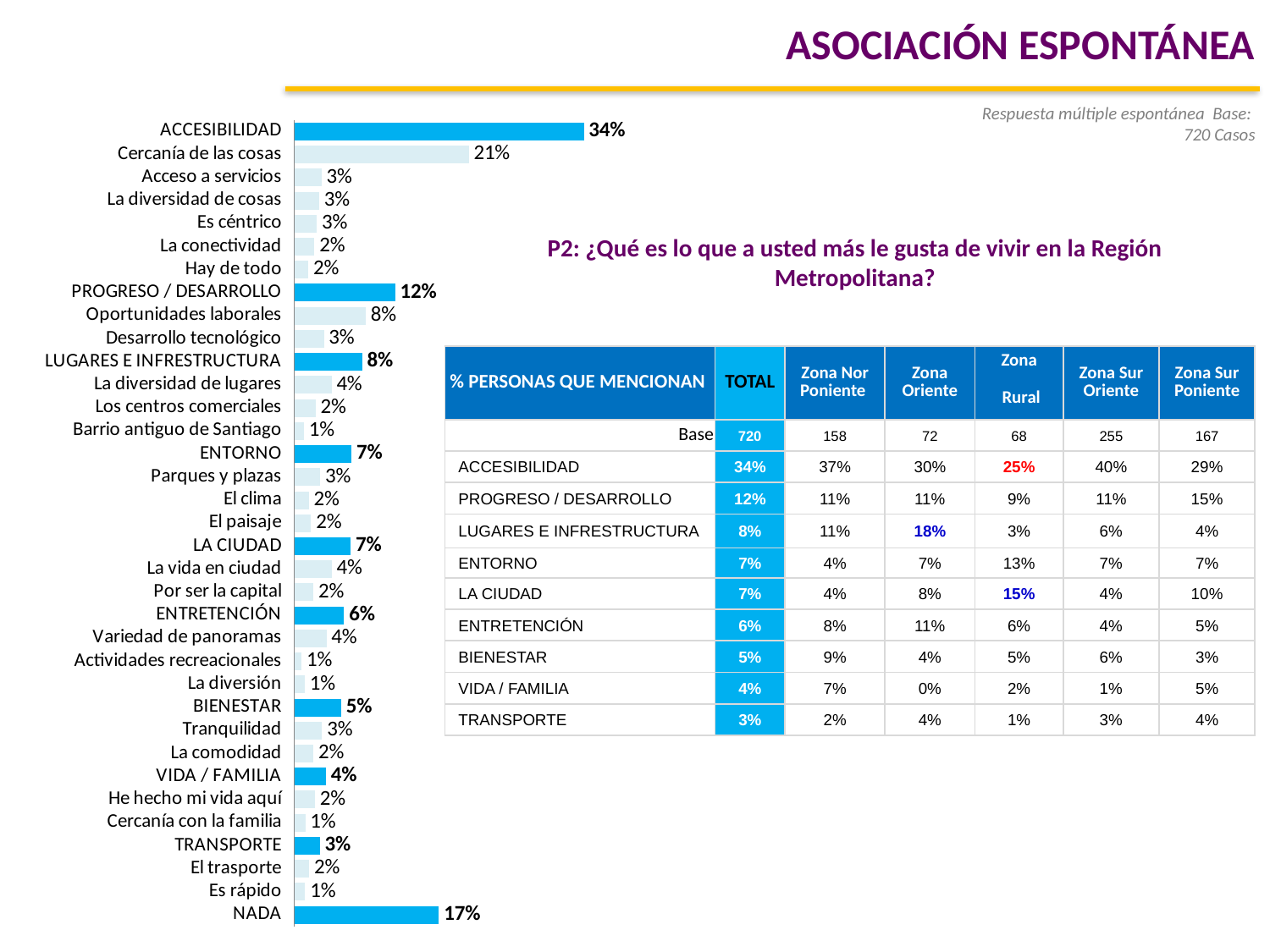
What is the difference between PROGRESO / DESARROLLO and LUGARES E INFRESTRUCTURA in the bar chart? 4% What is the value for Oportunidades laborales in the bar chart? 8% What is the difference between ACCESIBILIDAD and NADA in the bar chart? 17% Which is larger in the bar chart, Cercanía de las cosas or NADA? Cercanía de las cosas What is the value for ACCESIBILIDAD in the bar chart? 34% What is the value for NADA in the bar chart? 17% How many categories are plotted in the bar chart? 35 What kind of chart is shown on the left of the slide? Bar chart What is the value for Cercanía de las cosas in the bar chart? 21% Which is larger in the bar chart, ENTRETENCIÓN or BIENESTAR? ENTRETENCIÓN Which category has the highest value in the bar chart? ACCESIBILIDAD What is the value for PROGRESO / DESARROLLO in the bar chart? 12%